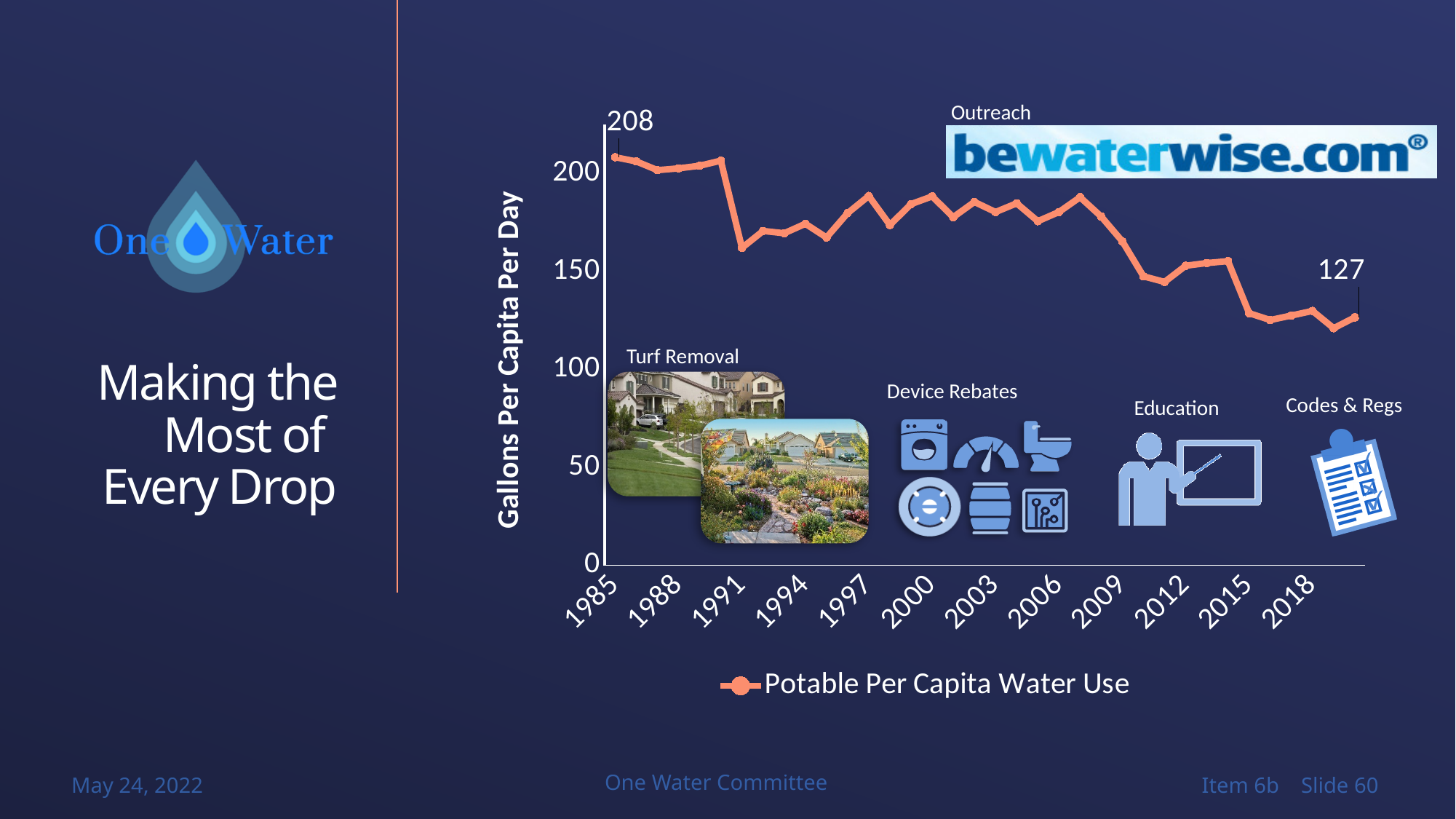
What is the title of the vertical axis? Gallons Per Capita Per Day Is the value for 2018 greater or less than 150? less In which year does the line reach its highest value? 1985 Is the value for 2000 greater or less than 150? greater By how much did Potable Per Capita Water Use fall from the 1985 value to the final labelled value? 81 How many series does the legend list? 1 What kind of chart is shown on the slide? line chart What series name is shown in the legend? Potable Per Capita Water Use What is the value shown at the last data point of the line? 127 Which is larger, the value in 1985 or the final labelled value? 1985 Do the values generally rise or fall from 1985 to the end of the series? fall What is the value of Potable Per Capita Water Use in 1985? 208